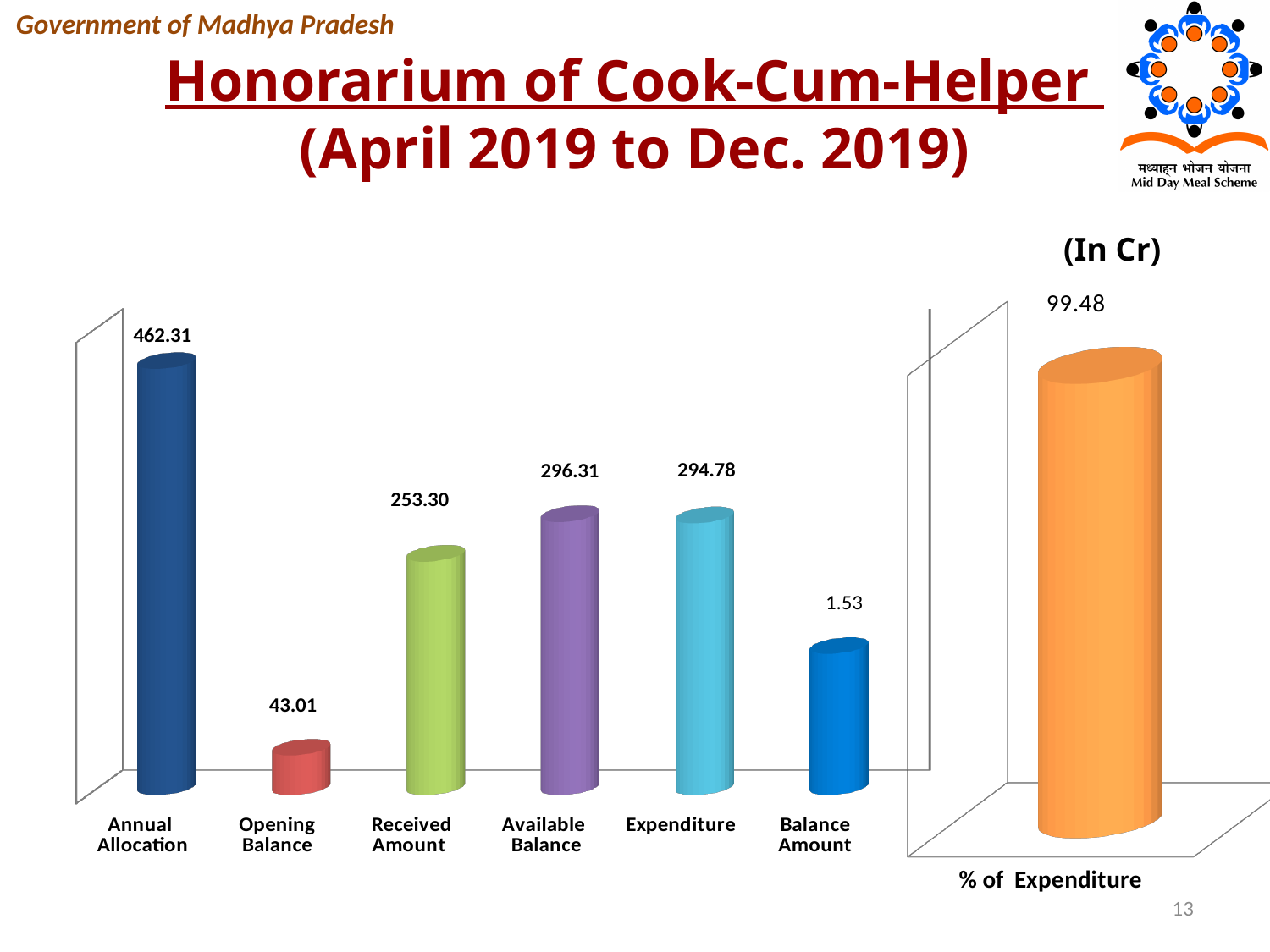
In the left chart, which category has the highest value? Annual Allocation In the right chart, what is the value for % of Expenditure? 99.48 What kind of chart is the left chart? Bar chart How many categories are shown in the left chart? 6 In the left chart, what is the difference between Annual Allocation and Opening Balance? 419.30 In the left chart, what is the value for Expenditure? 294.78 In the left chart, what is the value for Opening Balance? 43.01 In the left chart, what is the value for Annual Allocation? 462.31 In the left chart, what is the value for Balance Amount? 1.53 In the left chart, which is larger, Received Amount or Opening Balance? Received Amount In the left chart, what is the difference between Available Balance and Expenditure? 1.53